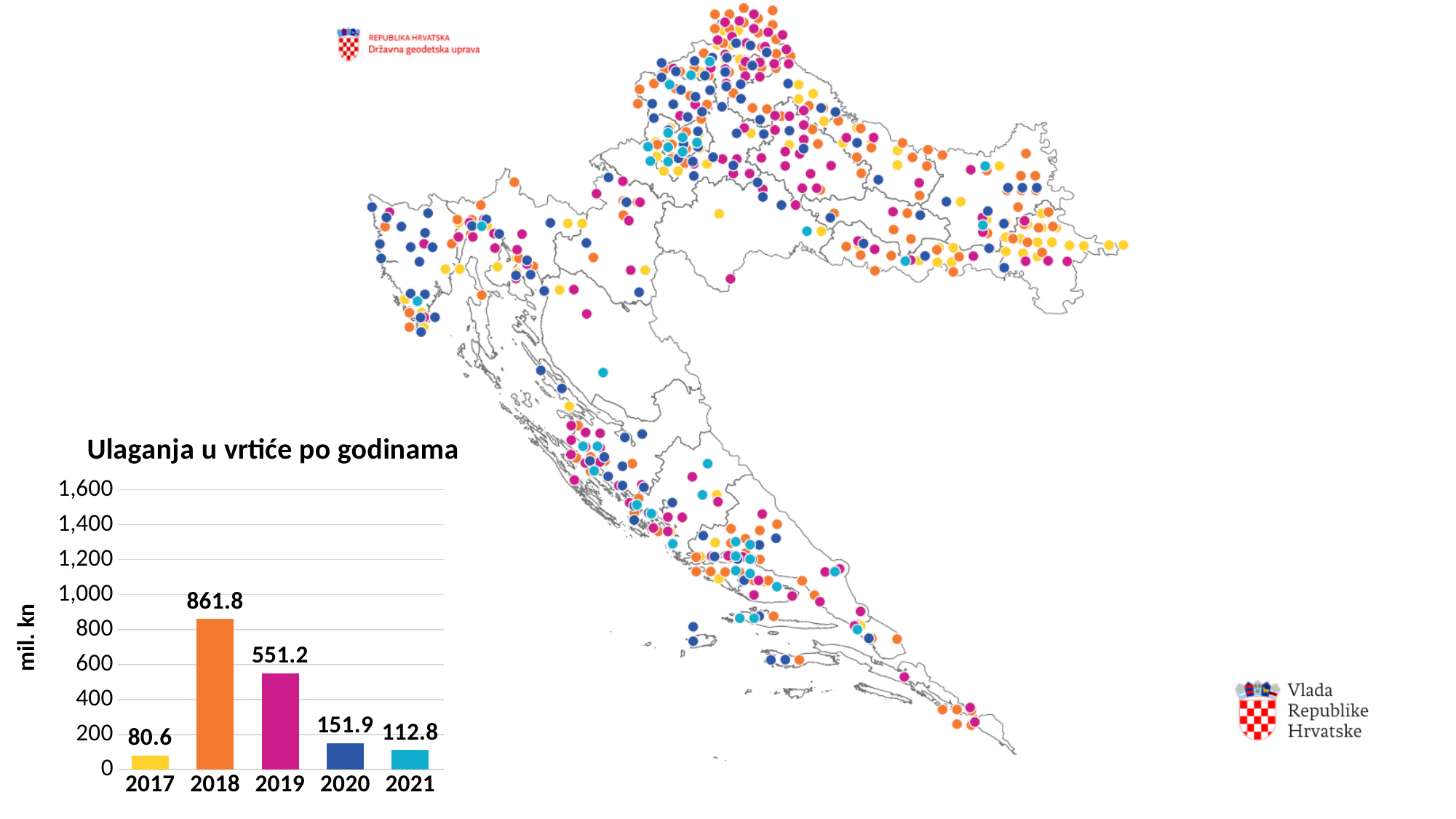
Which year has the lowest value in the 'Ulaganja u vrtiće po godinama' chart? 2017 What is the difference between the values for 2018 and 2019 in the 'Ulaganja u vrtiće po godinama' chart? 310.6 What kind of chart is 'Ulaganja u vrtiće po godinama'? bar chart Which is larger in the 'Ulaganja u vrtiće po godinama' chart, the value for 2020 or the value for 2021? 2020 Is the value for 2019 in the 'Ulaganja u vrtiće po godinama' chart greater or less than 400? greater What is the y-axis label of the 'Ulaganja u vrtiće po godinama' chart? mil. kn What is the value for 2018 in the 'Ulaganja u vrtiće po godinama' chart? 861.8 What is the value for 2021 in the 'Ulaganja u vrtiće po godinama' chart? 112.8 How many years are shown in the 'Ulaganja u vrtiće po godinama' chart? 5 Which year has the highest value in the 'Ulaganja u vrtiće po godinama' chart? 2018 Do the values in the 'Ulaganja u vrtiće po godinama' chart rise or fall from 2018 to 2020? fall What is the value for 2017 in the 'Ulaganja u vrtiće po godinama' chart? 80.6